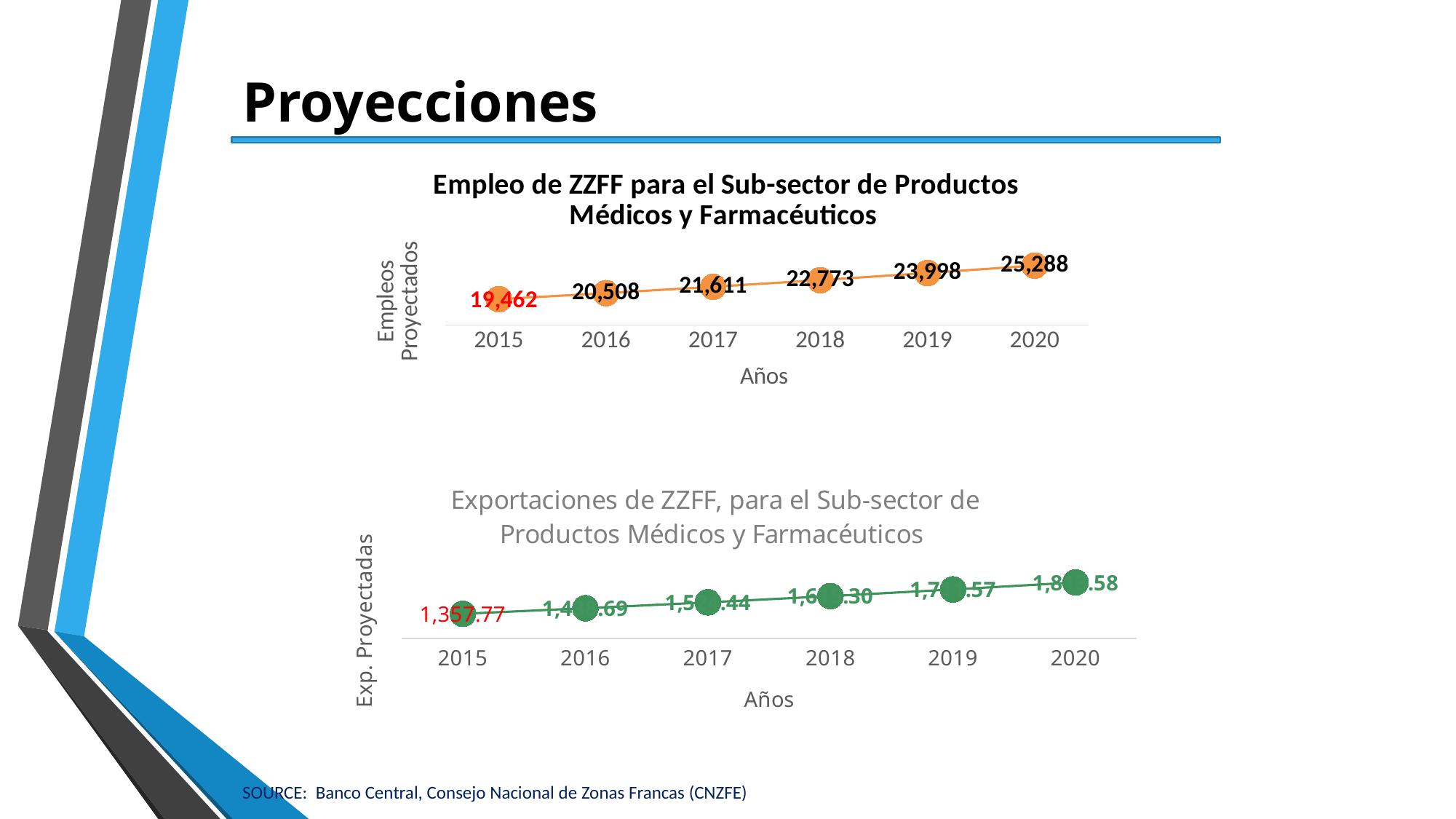
In the bottom chart (Exportaciones de ZZFF), do the projected exports rise or fall from 2015 to 2020? rise In the top chart (Empleo de ZZFF), what is the difference between the 2019 value and the 2018 value? 1,225 In the top chart (Empleo de ZZFF), which year has the lowest projected employment? 2015 In the top chart (Empleo de ZZFF), how many years are plotted on the x axis? 6 In the top chart (Empleo de ZZFF), do the values rise or fall from 2015 to 2020? rise In the top chart (Empleo de ZZFF), what is the projected employment value for 2020? 25,288 In the top chart (Empleo de ZZFF), what is the projected employment value for 2015? 19,462 In the top chart (Empleo de ZZFF), which year has the highest projected employment? 2020 In the bottom chart (Exportaciones de ZZFF), what is the value shown for 2015? 1,357.77 In the top chart (Empleo de ZZFF), which is larger, the value for 2017 or the value for 2016? 2017 In the top chart (Empleo de ZZFF), what is the value shown for 2018? 22,773 In the top chart (Empleo de ZZFF), what is the difference between the 2020 value and the 2015 value? 5,826